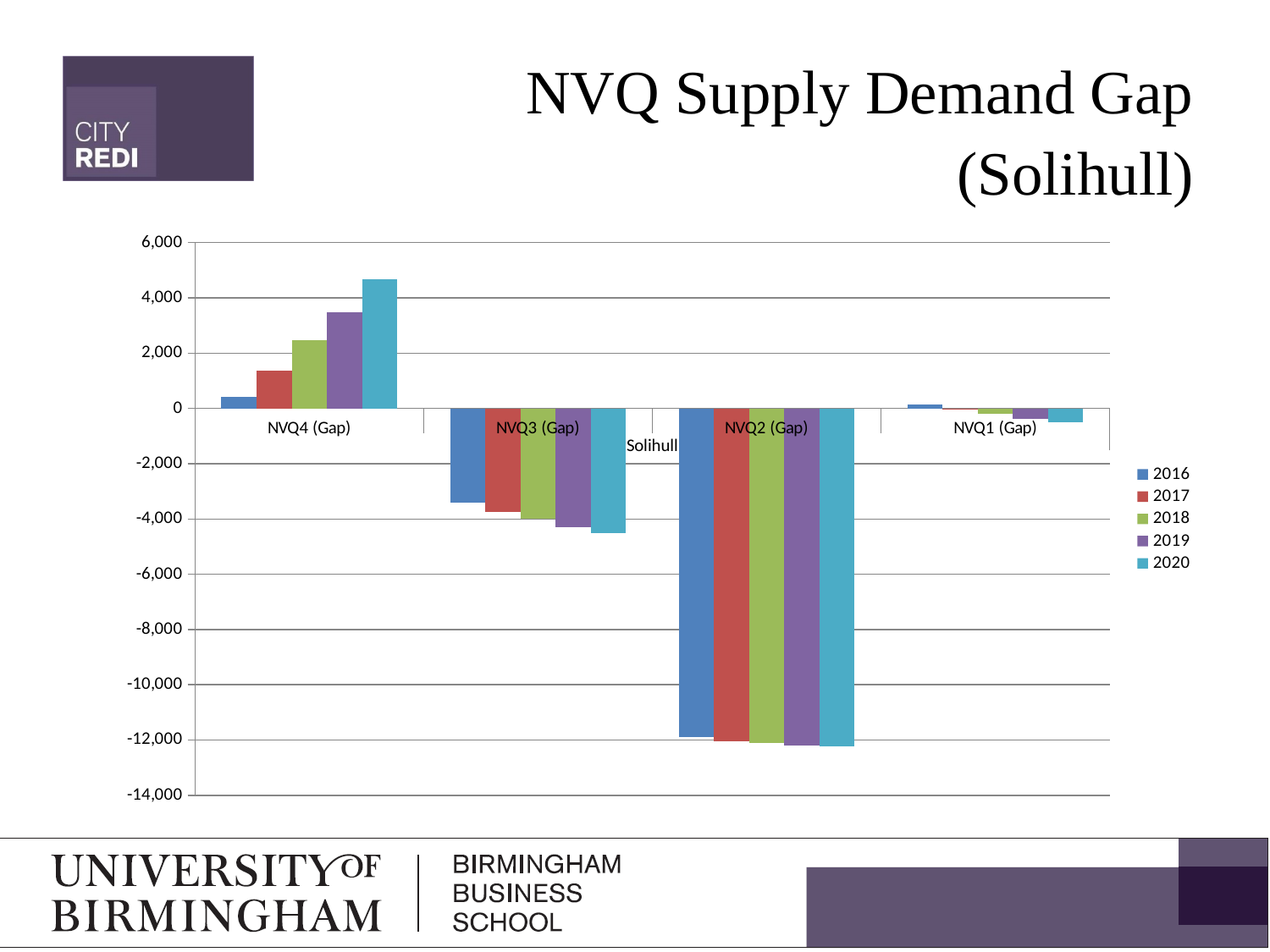
For NVQ4 (Gap), do the values rise or fall from 2016 to 2020? rise What kind of chart is shown on the slide? bar chart For NVQ4 (Gap), which is larger: the 2016 value or the 2020 value? 2020 Is the 2016 value for NVQ4 (Gap) greater or less than 2,000? less Is the 2020 value for NVQ4 (Gap) greater or less than 4,000? greater Is the 2020 value for NVQ3 (Gap) greater or less than -4,000? less What is the title of the chart on the slide? NVQ Supply Demand Gap (Solihull) Which category has the lowest (most negative) values in the chart? NVQ2 (Gap) How many series does the legend list? 5 How many categories are shown on the x axis of the chart? 4 Which category has the highest (most positive) values in the chart? NVQ4 (Gap)